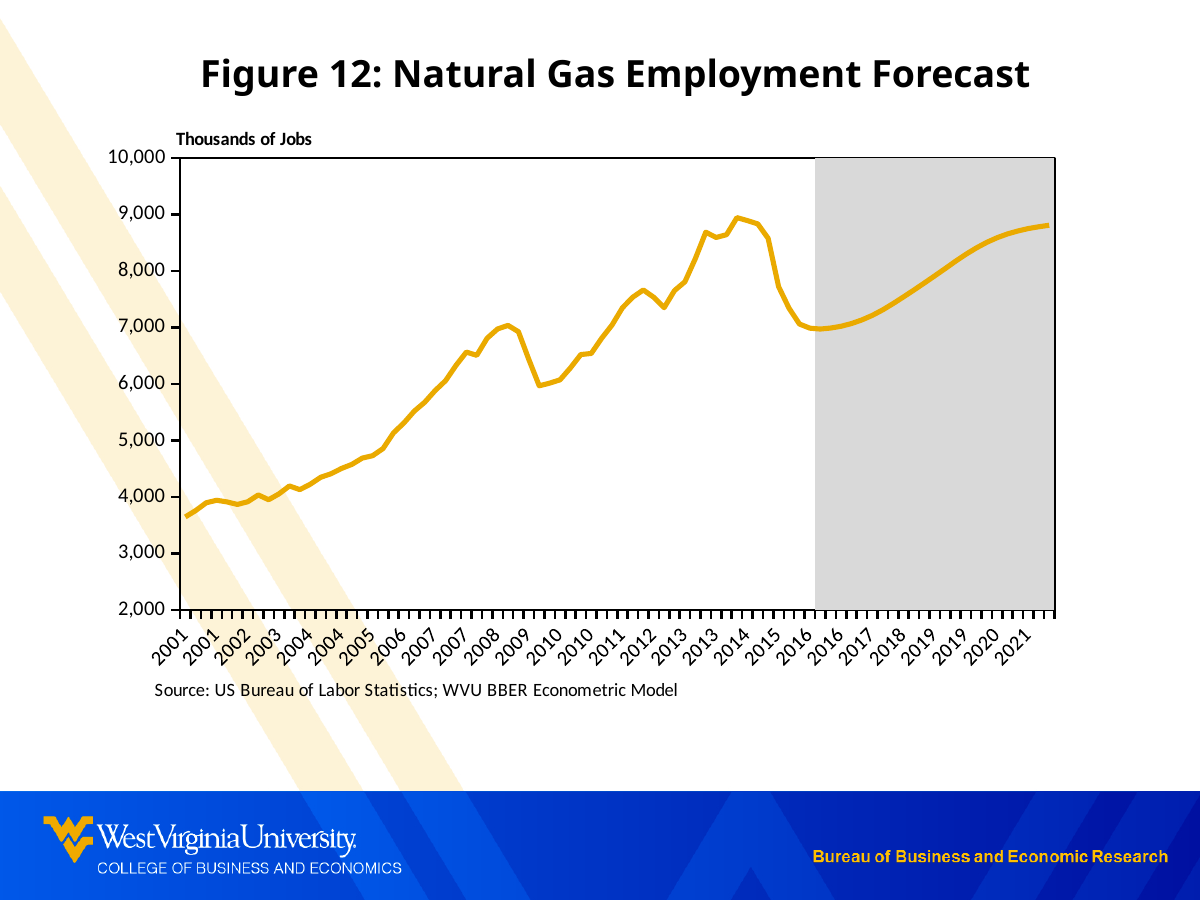
Is the value in 2016 greater or less than 8,000? less What is the title of the chart? Figure 12: Natural Gas Employment Forecast Is the value at the start of 2001 greater or less than 4,000? less In which year does the line reach its highest point? 2014 Is the value at the end of 2021 greater or less than 8,000? greater What unit label is shown above the vertical axis? Thousands of Jobs In which year is the line at its lowest point? 2001 Does the line rise or fall between 2014 and 2016? fall Does the line rise or fall across the shaded forecast period from 2016 to 2021? rise What kind of chart is shown on the slide? line chart